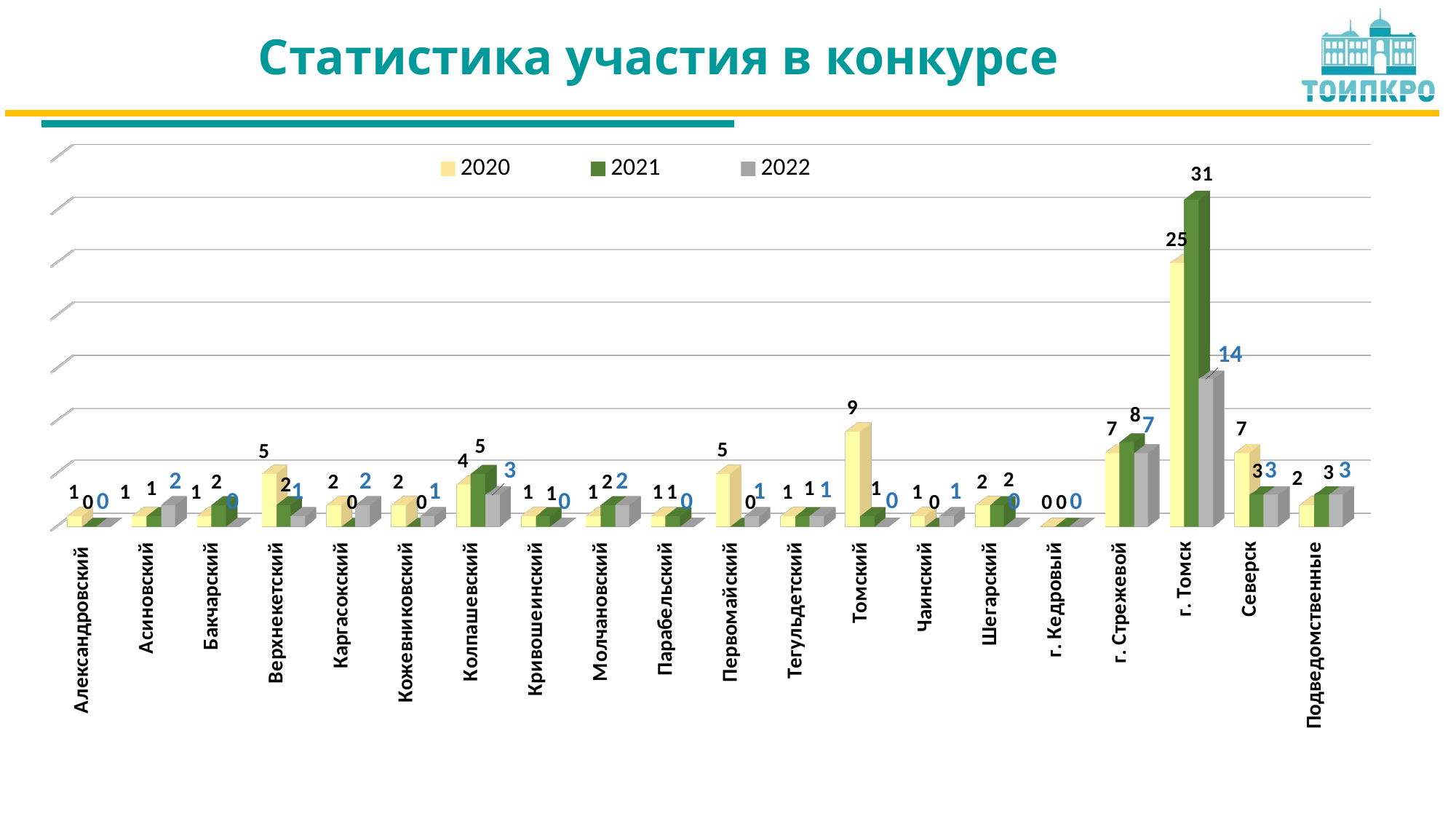
What is the title of the chart? Статистика участия в конкурсе How many categories are shown on the x axis? 20 What is the difference between the 2021 and 2022 values for г. Томск? 17 What is the difference between the 2020 and 2021 values for Верхнекетский? 3 What kind of chart is shown on the slide? Bar chart What is the 2021 value for г. Томск? 31 What is the 2020 value for Северск? 7 Which is larger for Колпашевский: the 2020 value or the 2021 value? 2021 What is the 2020 value for Томский? 9 What is the 2022 value for г. Стрежевой? 7 How many series does the legend list? 3 Which category has the highest 2022 value? г. Томск